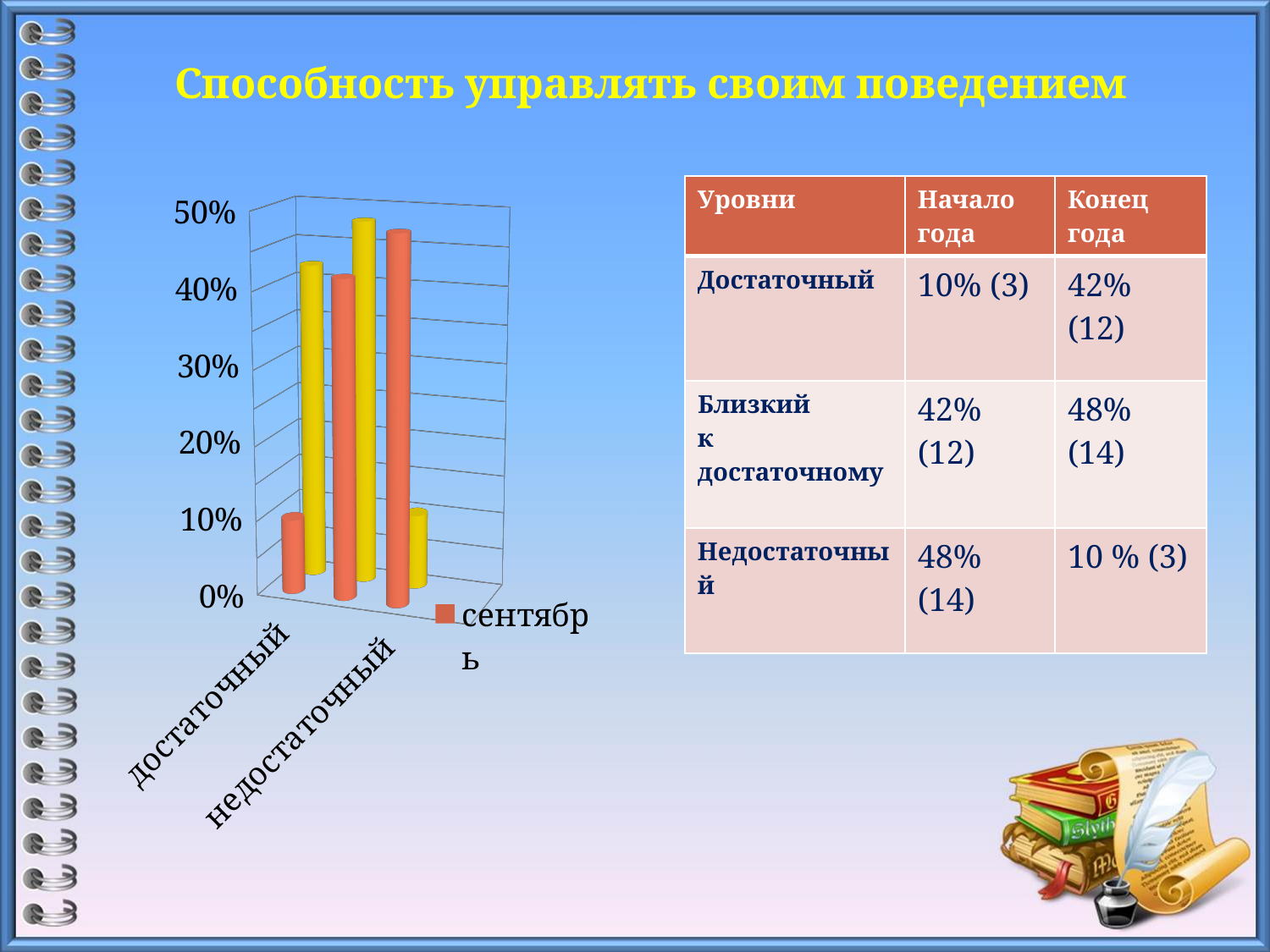
Is the orange (сентябрь) bar for Недостаточный greater or less than 40%? greater Is the yellow bar for Достаточный greater or less than 30%? greater What kind of chart is shown on the slide? bar chart What is the title of the slide above the chart? Способность управлять своим поведением Do the orange (сентябрь) bars rise or fall from left to right across the categories? rise Among the orange (сентябрь) bars, which labelled category has the lowest value? Достаточный Is the yellow bar for Недостаточный greater or less than 20%? less Which series name is shown in the chart's legend? сентябрь For the category Достаточный, which bar is taller, the orange one or the yellow one? yellow How many bars are plotted in the chart in total? 6 What is the highest value shown on the chart's vertical axis? 50%